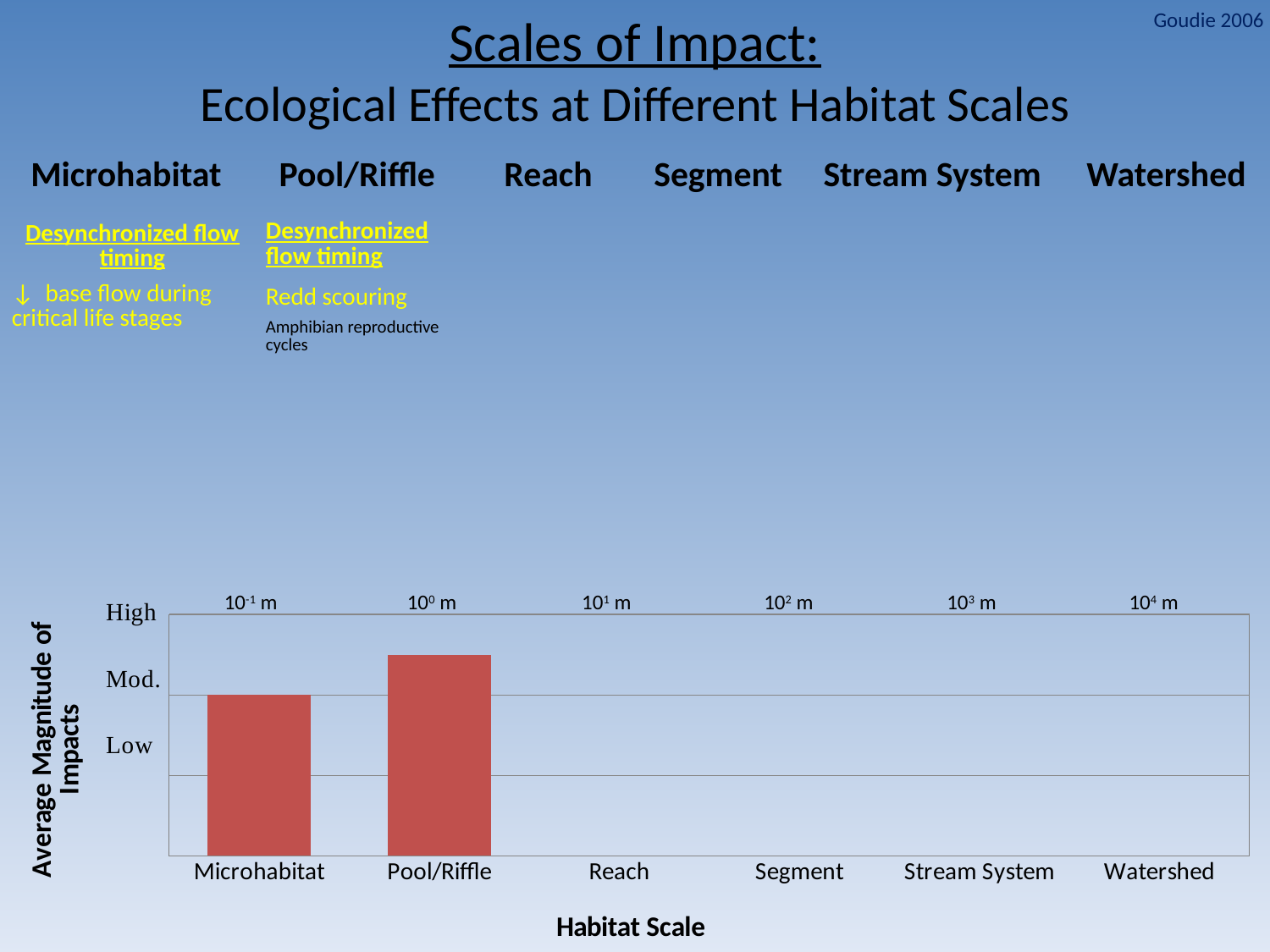
What kind of chart is shown at the bottom of the slide? Bar chart Does the Pool/Riffle bar reach above or below the Mod. level on the y axis? above Does the Pool/Riffle bar reach above or below the High level on the y axis? below Which categories on the x axis have no bar plotted? Reach, Segment, Stream System, Watershed Does the Microhabitat bar reach above or below the Low level on the y axis? above What is the title of the chart's x axis? Habitat Scale Which category has the tallest bar in the chart? Pool/Riffle What scale label is printed above the Reach category in the chart? 10^1 m Which bar is taller, Microhabitat or Pool/Riffle? Pool/Riffle How many categories are listed along the x axis of the chart? 6 What is the title of the chart's y axis? Average Magnitude of Impacts How many categories in the chart have a visible bar plotted? 2